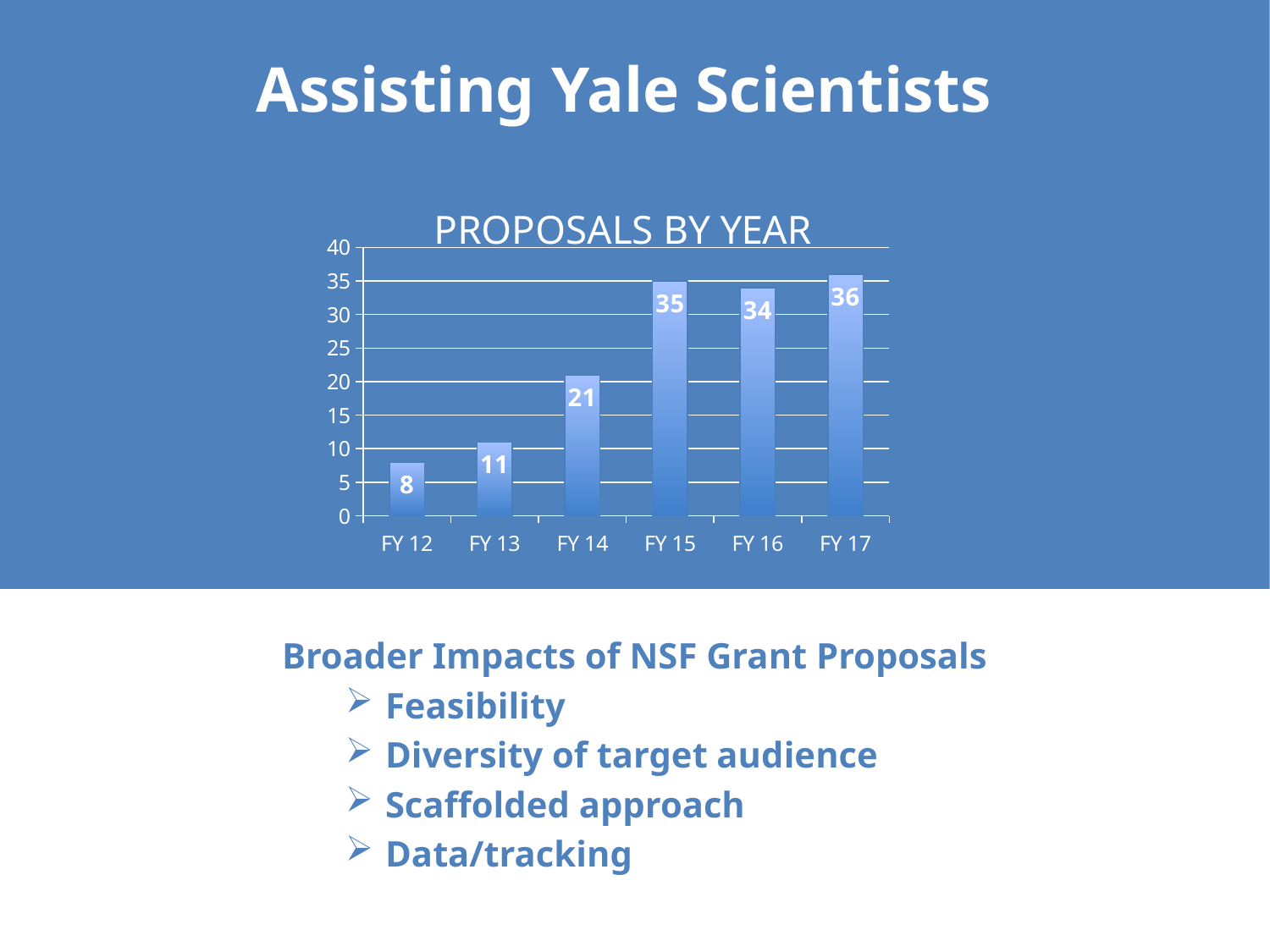
What is the title of the chart? PROPOSALS BY YEAR What is the difference between the values for FY 15 and FY 13? 24 What kind of chart is shown on the slide? bar chart Which is larger, the value for FY 14 or the value for FY 13? FY 14 What is the difference between the values for FY 17 and FY 16? 2 What is the value for FY 16? 34 Which year has the highest number of proposals? FY 17 Is the value for FY 15 greater or less than 30? greater What is the value for FY 14? 21 How many years are shown on the x axis? 6 What is the value for FY 12? 8 Which year has the lowest number of proposals? FY 12